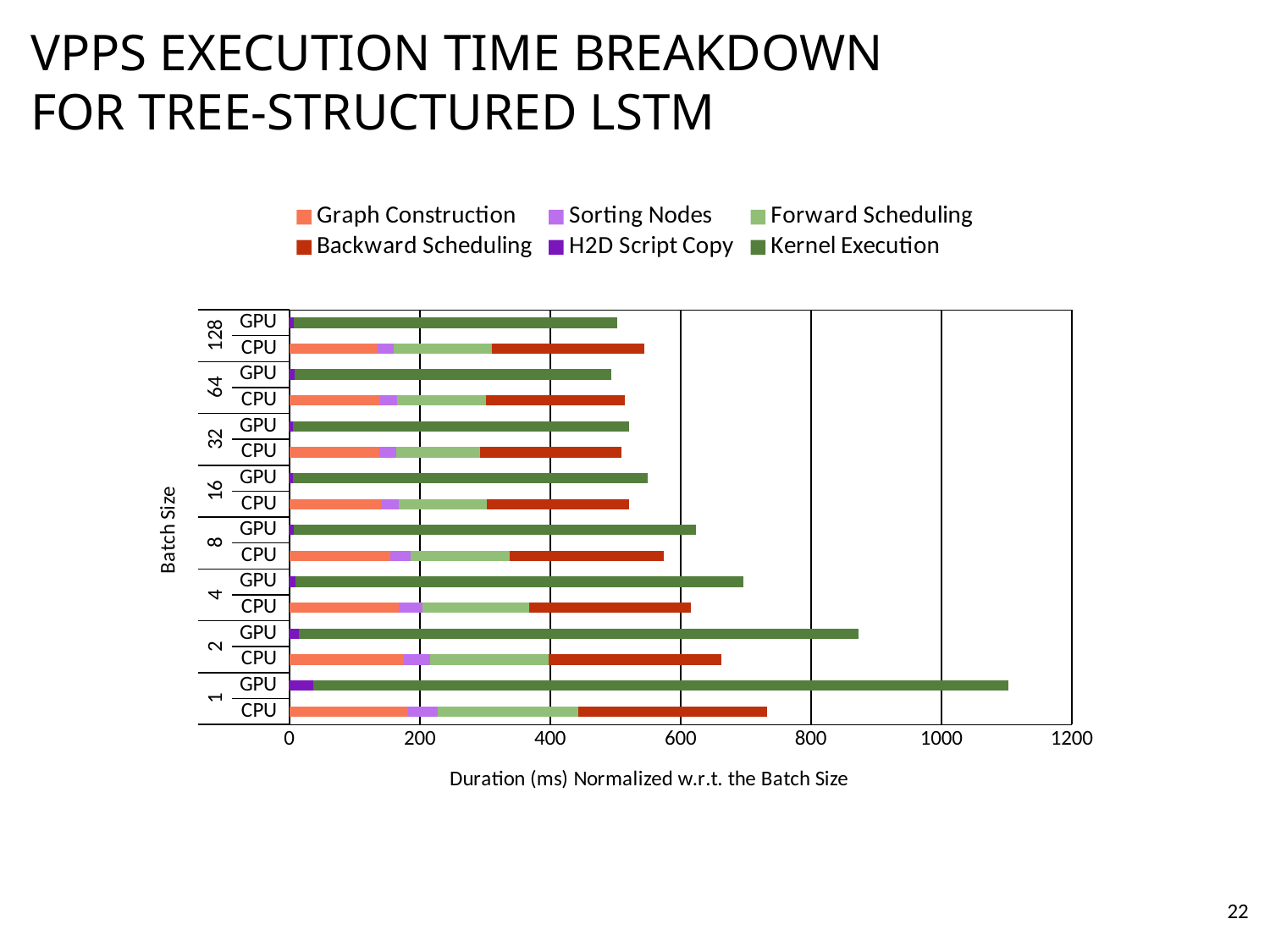
Is the total duration for GPU at batch size 1 greater or less than 1000? greater How many batch sizes are shown on the y axis? 8 How many series does the legend list? 6 What kind of chart is shown on the slide? Stacked bar chart As the batch size increases from 1 to 8, does the GPU total duration rise or fall? fall Which bar has the longest total duration? GPU at batch size 1 Is the total duration for GPU at batch size 2 greater or less than 800? greater Is the total duration for CPU at batch size 1 greater or less than 800? less At batch size 1, which has the larger total duration, CPU or GPU? GPU What is the title of the x axis? Duration (ms) Normalized w.r.t. the Batch Size How many bars are plotted in total (CPU and GPU for every batch size)? 16